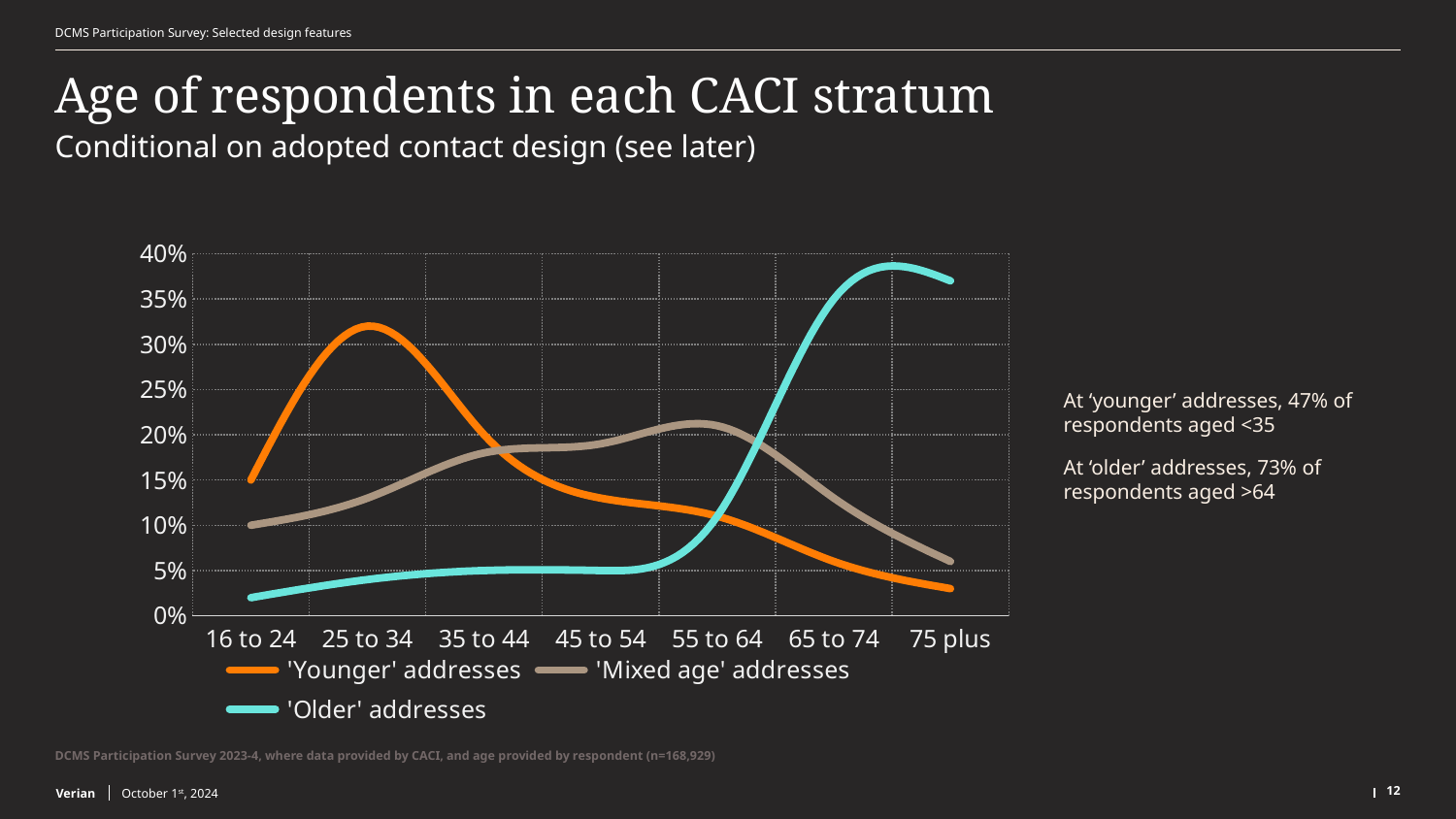
For 'Younger' addresses, which age group has the highest share of respondents? 25 to 34 At 75 plus, which is larger: 'Older' addresses or 'Younger' addresses? 'Older' addresses For 'Older' addresses, which age group has the lowest share of respondents? 16 to 24 How many series does the legend list? 3 At 16 to 24, which is larger: 'Younger' addresses or 'Older' addresses? 'Younger' addresses Is the value for 'Younger' addresses at 25 to 34 greater or less than 30%? greater What kind of chart is shown on the slide? Line chart For 'Younger' addresses, which age group has the lowest share of respondents? 75 plus What is the title of the chart slide? Age of respondents in each CACI stratum Is the value for 'Mixed age' addresses at 55 to 64 greater or less than 25%? less How many age groups are shown on the x axis? 7